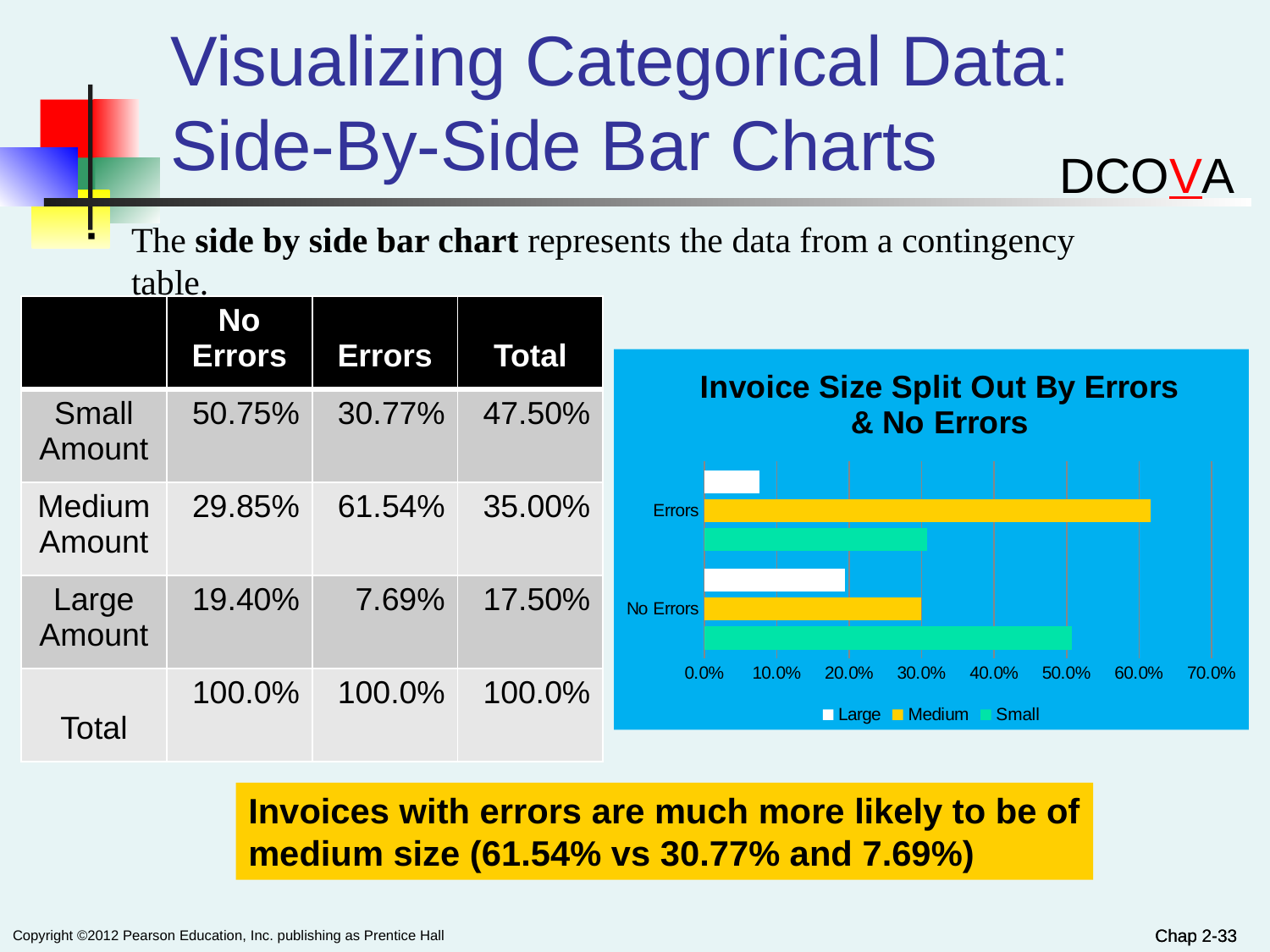
How many categories are shown on the chart's vertical axis? 2 Is the Large bar for Errors greater or less than 10.0%? less In the Errors category, which series has the shortest bar? Large Is the Medium bar for Errors greater or less than 50.0%? greater In the Errors category, which series has the longest bar? Medium How many series does the chart legend list? 3 What type of chart is shown on the slide? bar chart Which is larger: the Small bar for No Errors or the Small bar for Errors? Small bar for No Errors Which series is shown in yellow in the chart? Medium Is the Small bar for No Errors greater or less than 40.0%? greater What is the title of the chart? Invoice Size Split Out By Errors & No Errors In the No Errors category, which series has the longest bar? Small